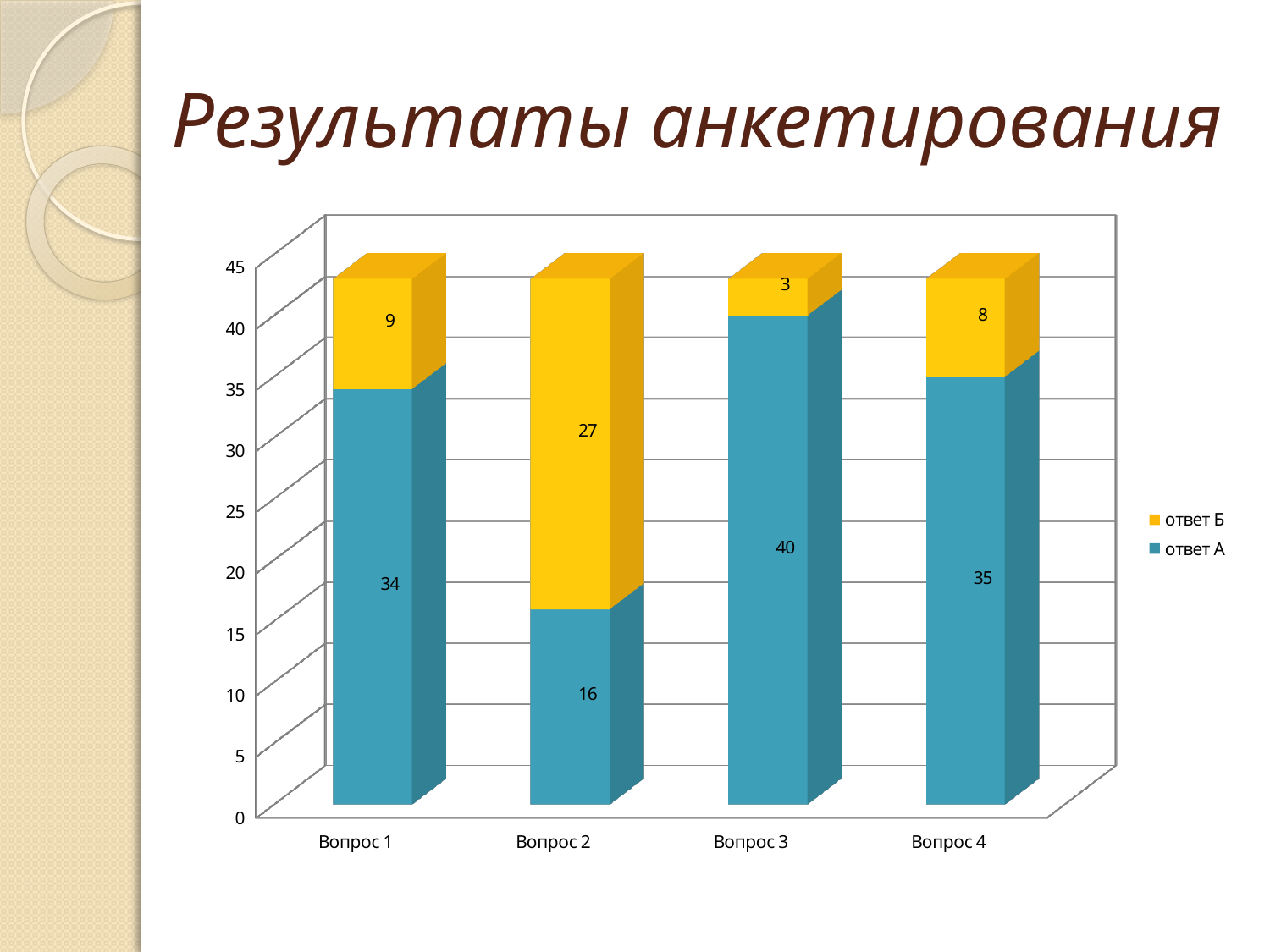
Which question has the highest value for ответ А? Вопрос 3 What kind of chart is shown on the slide? Stacked bar chart Which is larger for Вопрос 1: ответ А or ответ Б? ответ А What is the value of ответ Б for Вопрос 2? 27 What is the value of ответ Б for Вопрос 4? 8 What is the value of ответ А for Вопрос 3? 40 How many categories are shown on the x axis? 4 What is the value of ответ А for Вопрос 1? 34 How many series does the legend list? 2 Which question has the lowest value for ответ Б? Вопрос 3 What is the total of the stacked bar for Вопрос 4? 43 What is the difference between ответ А and ответ Б for Вопрос 2? 11